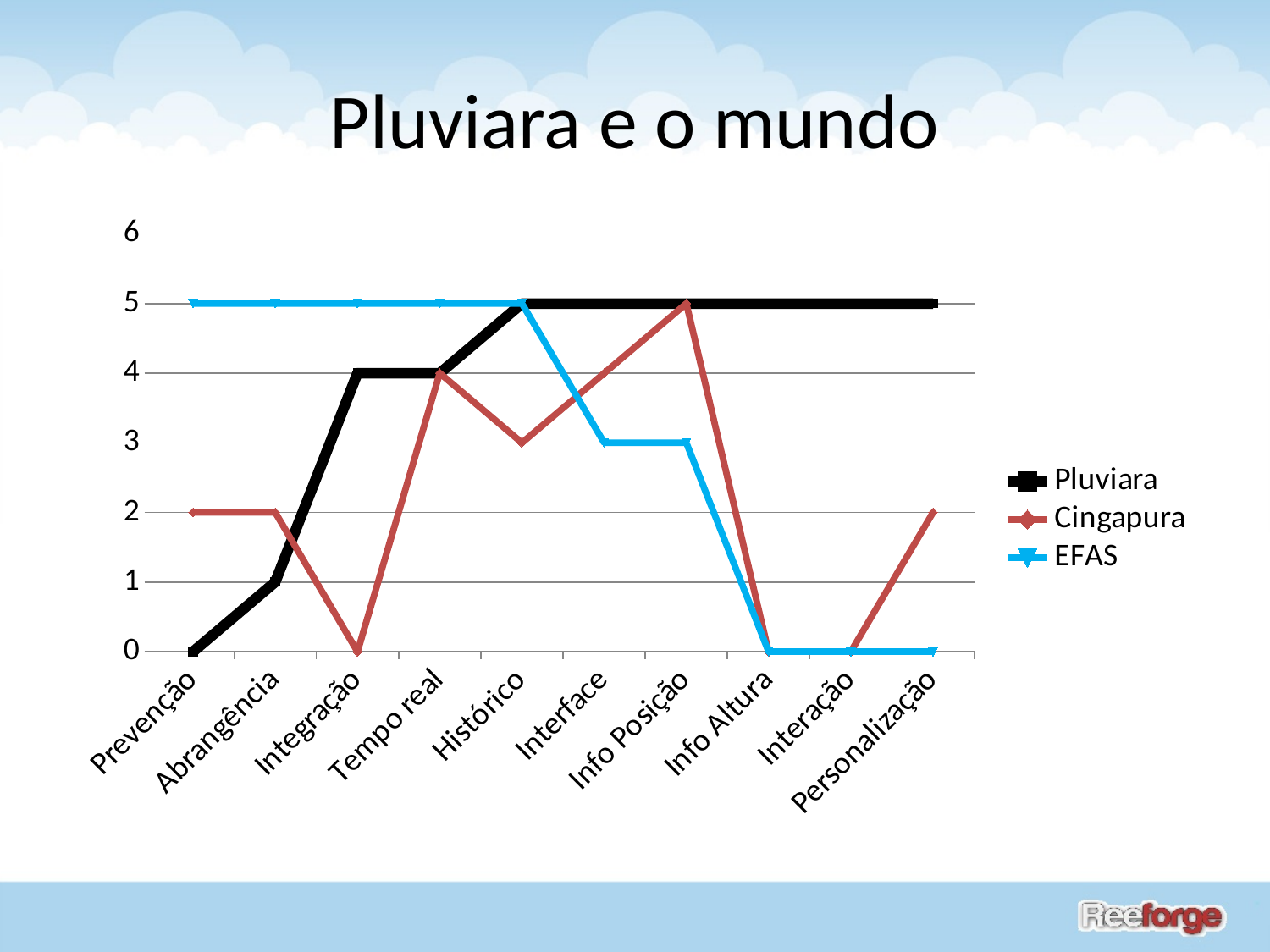
What is the value for Pluviara at Integração? 4 Which series has the higher value at Abrangência, Pluviara or EFAS? EFAS How many categories are shown on the x axis? 10 How many series does the legend list? 3 What is the value for Pluviara at Prevenção? 0 What is the difference between the Pluviara and Cingapura values at Integração? 4 What is the title of the chart? Pluviara e o mundo What is the value for Cingapura at Info Posição? 5 Does the Pluviara series rise or fall from Prevenção to Histórico? rise What kind of chart is shown on the slide? line chart At which category does Cingapura reach its highest value? Info Posição What is the value for EFAS at Interface? 3